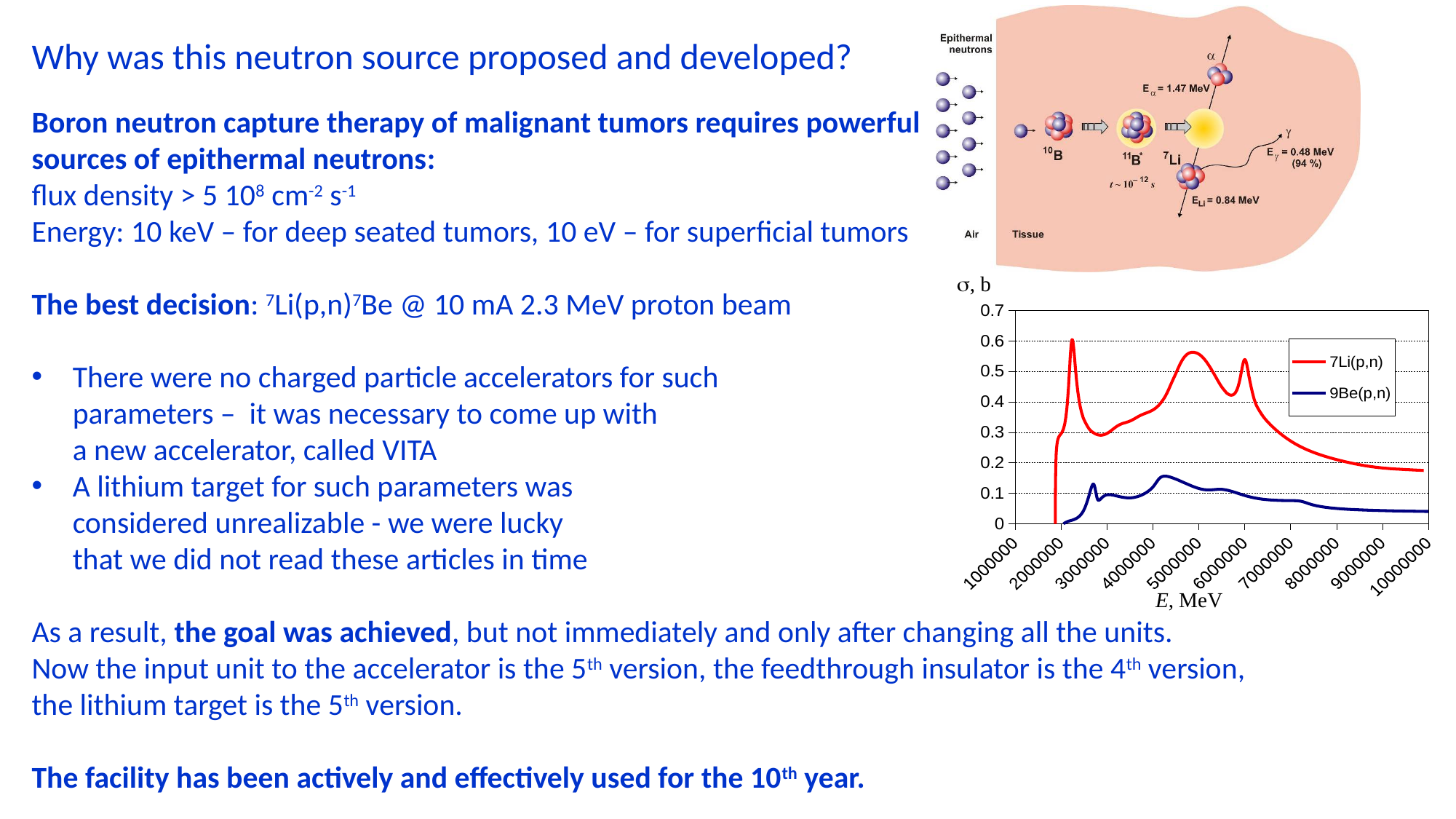
Is the value of the 9Be(p,n) curve at 10000000 greater or less than 0.1? less What is the highest value shown on the chart's y axis? 0.7 Is the value of the 7Li(p,n) curve at 10000000 greater or less than 0.1? greater Which series has the higher cross section across the plotted energy range, 7Li(p,n) or 9Be(p,n)? 7Li(p,n) Is the peak value of the 7Li(p,n) curve greater or less than 0.5? greater What colour is the 7Li(p,n) line in the chart? red Does the 7Li(p,n) curve rise or fall between 7000000 and 10000000 on the x axis? fall What kind of chart is shown on the slide? line chart What are the two series named in the chart legend? 7Li(p,n) and 9Be(p,n) How many series does the chart legend list? 2